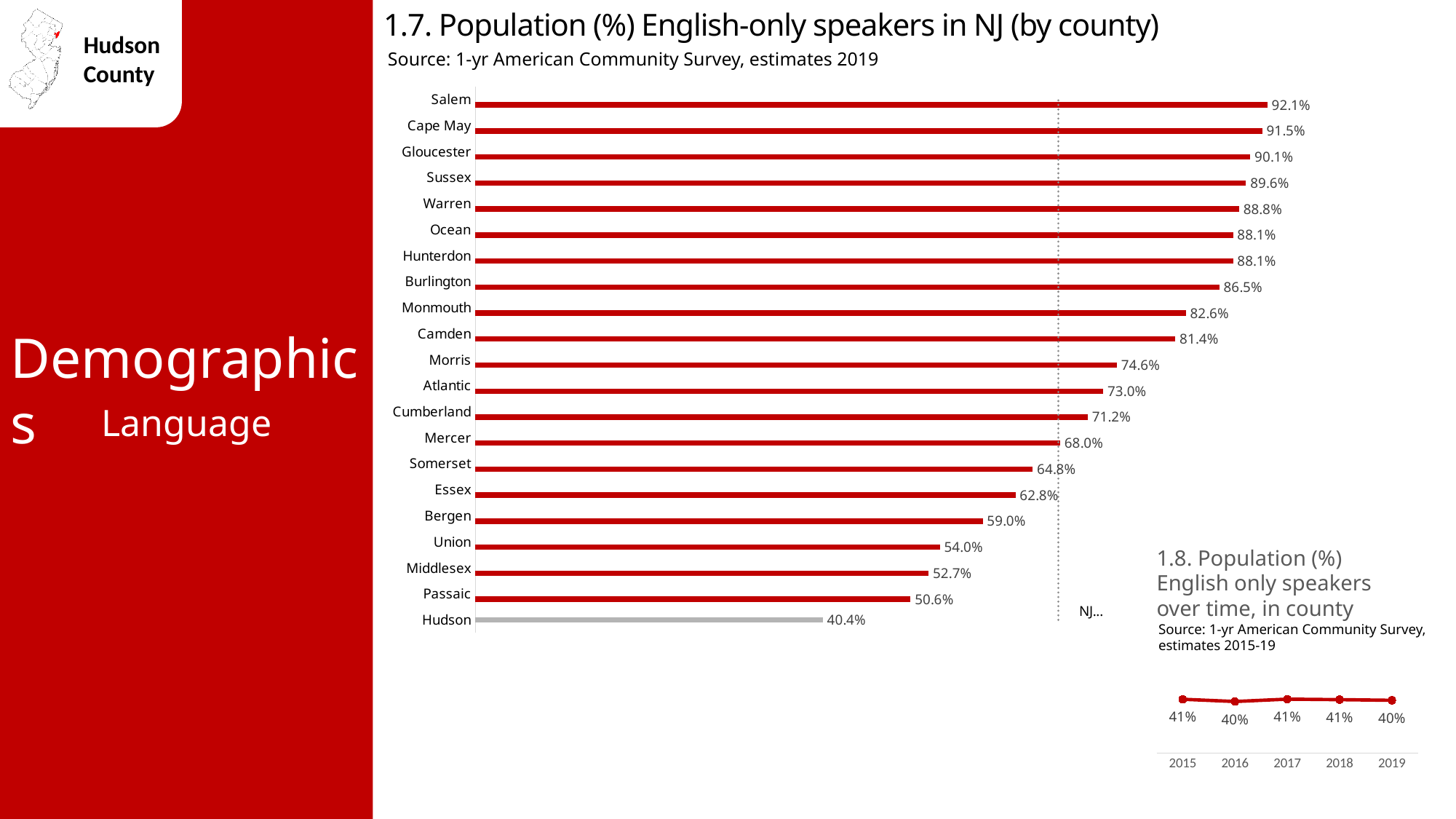
In chart 1.8 (English only speakers over time, in county), how many years are plotted? 5 In chart 1.7 (English-only speakers by county), which county has the highest value? Salem What kind of chart is chart 1.8 (English only speakers over time, in county)? Line chart In chart 1.8 (English only speakers over time, in county), what is the value for 2019? 40% In chart 1.7 (English-only speakers by county), what is the difference between Salem and Hudson? 51.7% In chart 1.7 (English-only speakers by county), what is the value for Bergen? 59.0% In chart 1.7 (English-only speakers by county), what is the value for Hudson? 40.4% What kind of chart is chart 1.7 (English-only speakers by county)? Bar chart In chart 1.7 (English-only speakers by county), how many counties are shown? 21 In chart 1.7 (English-only speakers by county), which is larger, the value for Morris or the value for Mercer? Morris In chart 1.7 (English-only speakers by county), what is the value for Passaic? 50.6% In chart 1.7 (English-only speakers by county), which county has the lowest value? Hudson